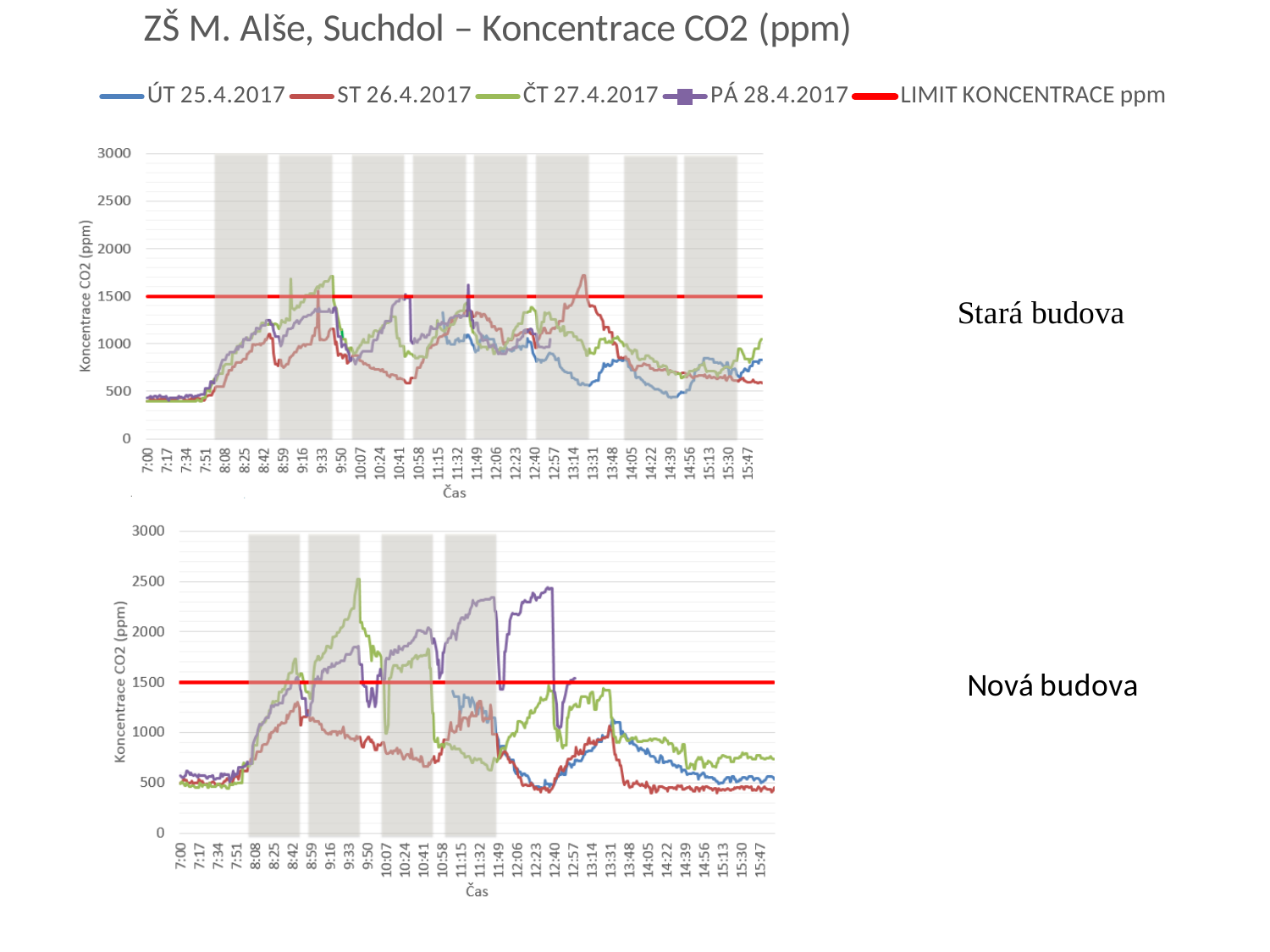
In the Nová budova chart, which series reaches a higher peak, ST 26.4.2017 or PÁ 28.4.2017? PÁ 28.4.2017 How many series does the legend list? 5 In the Stará budova chart, is the value of ÚT 25.4.2017 at 15:47 greater or less than 1000? less In the Nová budova chart, what value does the LIMIT KONCENTRACE ppm line sit at? 1500 In the Nová budova chart, does the ST 26.4.2017 series rise or fall between 13:31 and 15:47? fall What kind of chart is the Stará budova chart? line chart In the Stará budova chart, is the peak of ST 26.4.2017 around 13:14 greater or less than 1500? greater In the Nová budova chart, is the value of ČT 27.4.2017 at 15:47 greater or less than 1000? less How many charts are shown on the slide? 2 What is the label of the vertical axis on the Nová budova chart? Koncentrace CO2 (ppm)